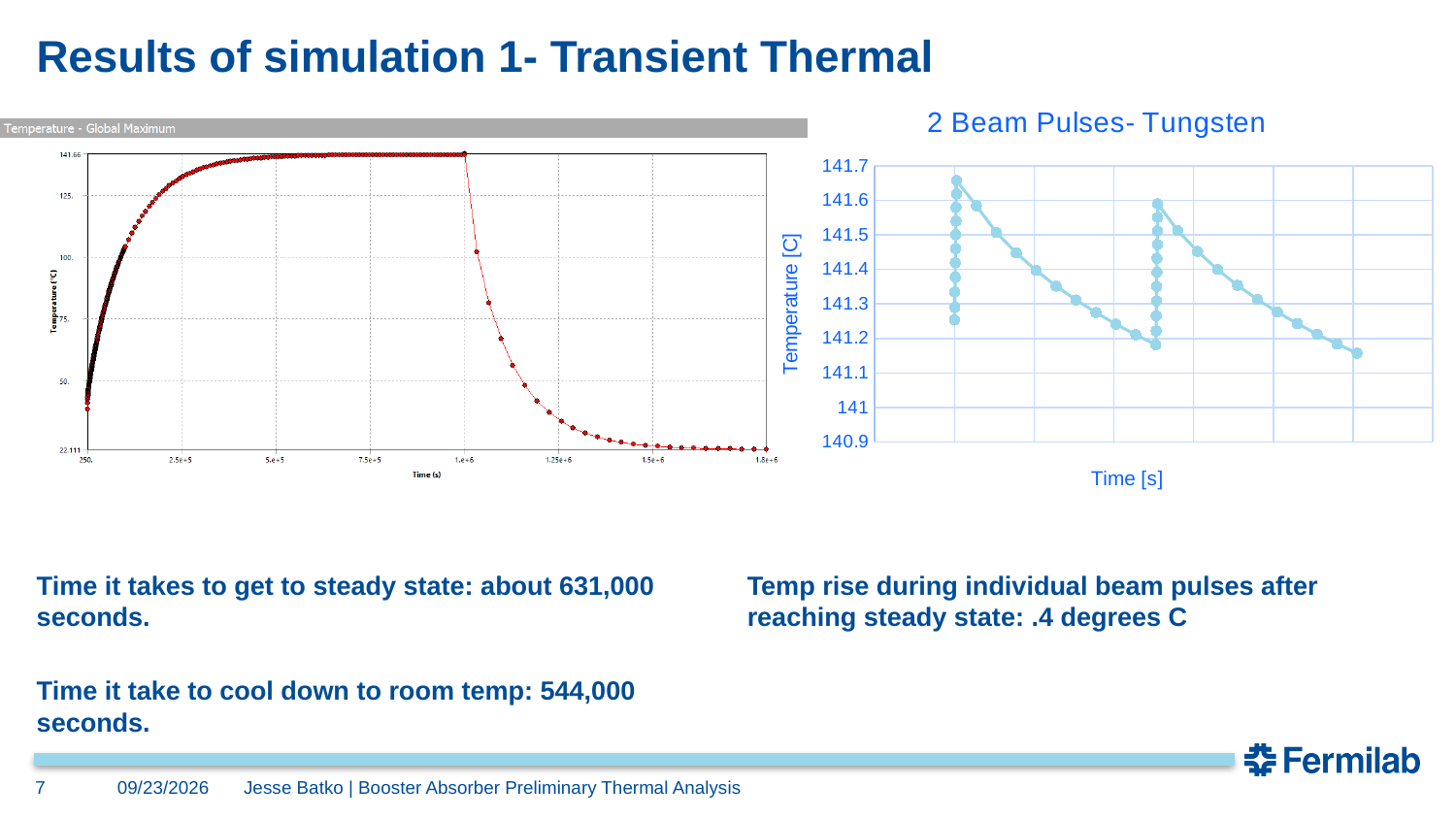
In the right-hand chart '2 Beam Pulses- Tungsten', is the peak temperature of the first pulse greater or less than 141.6? greater In the left-hand chart 'Temperature - Global Maximum', what is the lowest temperature value the curve reaches at the end, as marked on the y-axis? 22.111 What is the y-axis label of the right-hand chart? Temperature [C] In the right-hand chart '2 Beam Pulses- Tungsten', is the temperature of the last plotted point greater or less than 141.2? less In the left-hand chart 'Temperature - Global Maximum', is the temperature at 1.e+6 s greater or less than 125? greater What is the title of the right-hand chart? 2 Beam Pulses- Tungsten In the left-hand chart 'Temperature - Global Maximum', what is the maximum temperature value reached by the curve, as marked on the y-axis? 141.66 In the left-hand chart 'Temperature - Global Maximum', does the temperature rise or fall after 1.e+6 s? fall In the left-hand chart 'Temperature - Global Maximum', does the temperature rise or fall between 250 s and 5.e+5 s? rise What kind of chart is the right-hand chart titled '2 Beam Pulses- Tungsten'? line chart In the right-hand chart '2 Beam Pulses- Tungsten', which pulse reaches the higher peak temperature, the first or the second? the first